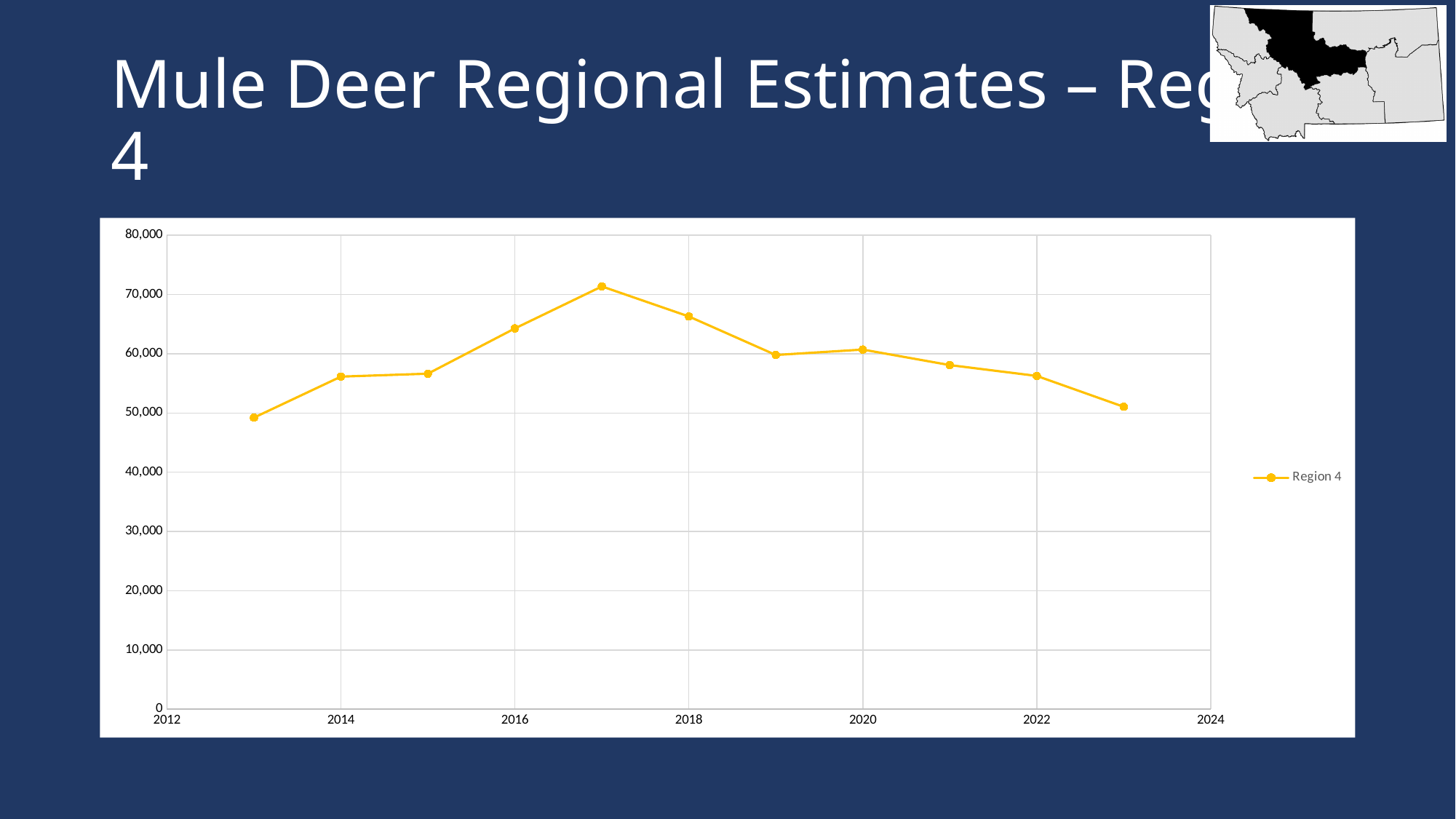
How many series does the legend list? 1 What kind of chart is shown on the slide? line chart In which year is the Region 4 estimate highest? 2017 Is the value for 2016 greater or less than 60,000? greater Is the value for 2017 greater or less than 70,000? greater Do the values rise or fall from 2017 to 2023? fall Is the value for 2013 greater or less than 50,000? less In which year is the Region 4 estimate lowest? 2013 What is the name of the series shown in the legend? Region 4 How many data points are plotted on the line? 11 Which year has the larger value, 2017 or 2023? 2017